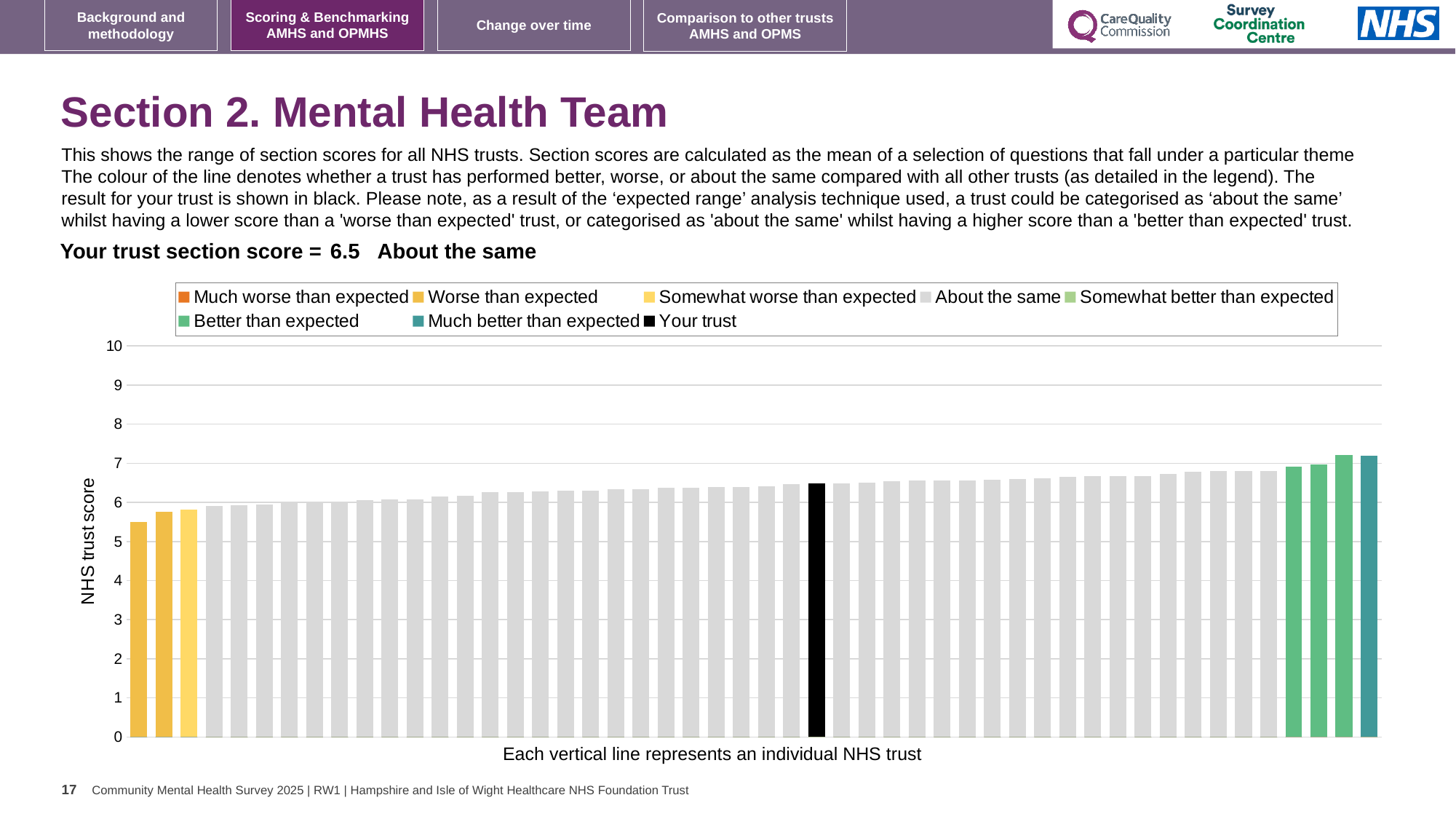
How many bars are coloured as 'Much better than expected' (teal)? 1 Is the value for your trust greater or less than 6? greater What is the title of the y axis? NHS trust score How many bars are coloured as 'Worse than expected' (yellow)? 2 Which is larger, the leftmost bar or the rightmost bar? the rightmost bar Is the value for the tallest bar greater or less than 8? less Is the value for the leftmost bar greater or less than 6? less What colour is the bar for your trust? black How many entries does the chart legend list? 8 What kind of chart is shown on the slide? bar chart Do the bar values rise or fall from left to right along the x axis? rise What is the section score for your trust? 6.5